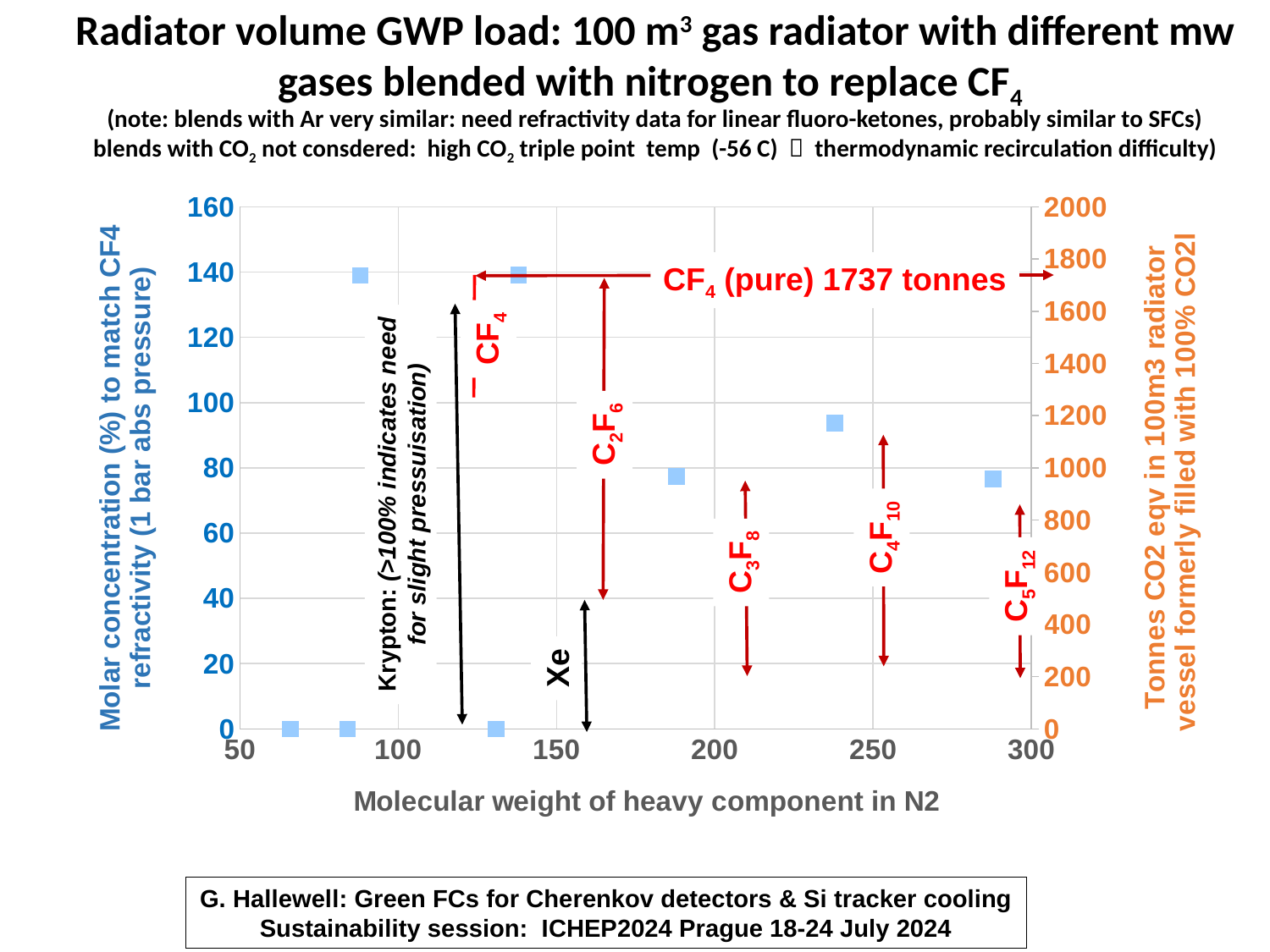
How many plotted points lie on the 0 line of the left axis? 3 What kind of chart is shown on the slide? scatter chart What is the title of the x axis? Molecular weight of heavy component in N2 How many data points are plotted on the chart? 8 What is the maximum value shown on the right-hand (orange) axis? 2000 According to the annotation, how many tonnes of CO2 equivalent does pure CF4 correspond to? 1737 tonnes